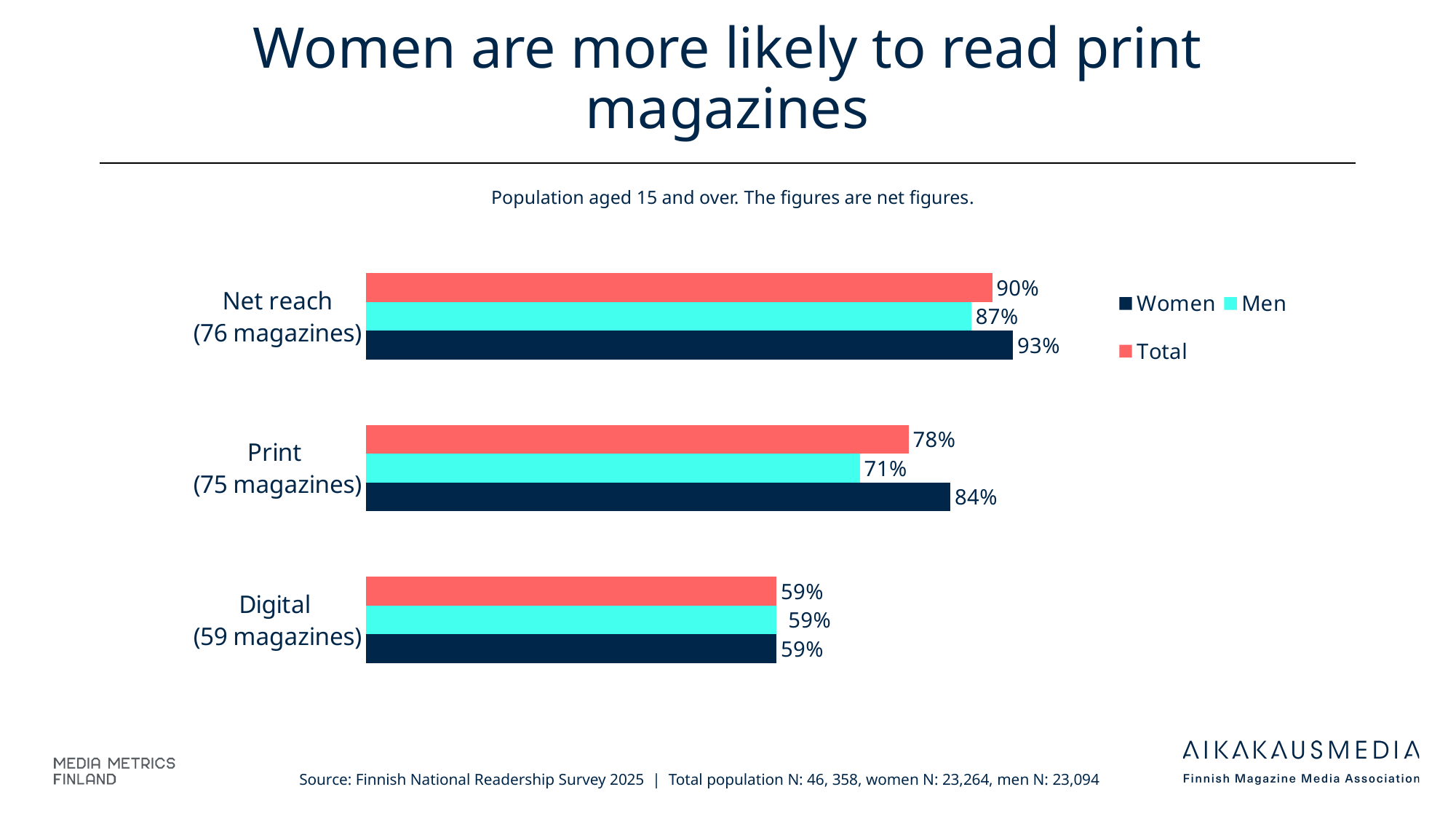
What kind of chart is shown on the slide? Bar chart How many series does the legend list? 3 What is the difference between the Women and Men values for Print (75 magazines)? 13 percentage points How many categories are shown on the chart? 3 What is the Total value for Print (75 magazines)? 78% What is the value for Women in the Net reach (76 magazines) category? 93% Which category has the lowest value for Men? Digital (59 magazines) What is the value for Men in the Print (75 magazines) category? 71% Which category has the highest value for Women? Net reach (76 magazines) Which is larger for Net reach (76 magazines): the Women value or the Men value? Women Which colour represents the Total series in the chart? Red (coral) What is the Total value for Digital (59 magazines)? 59%